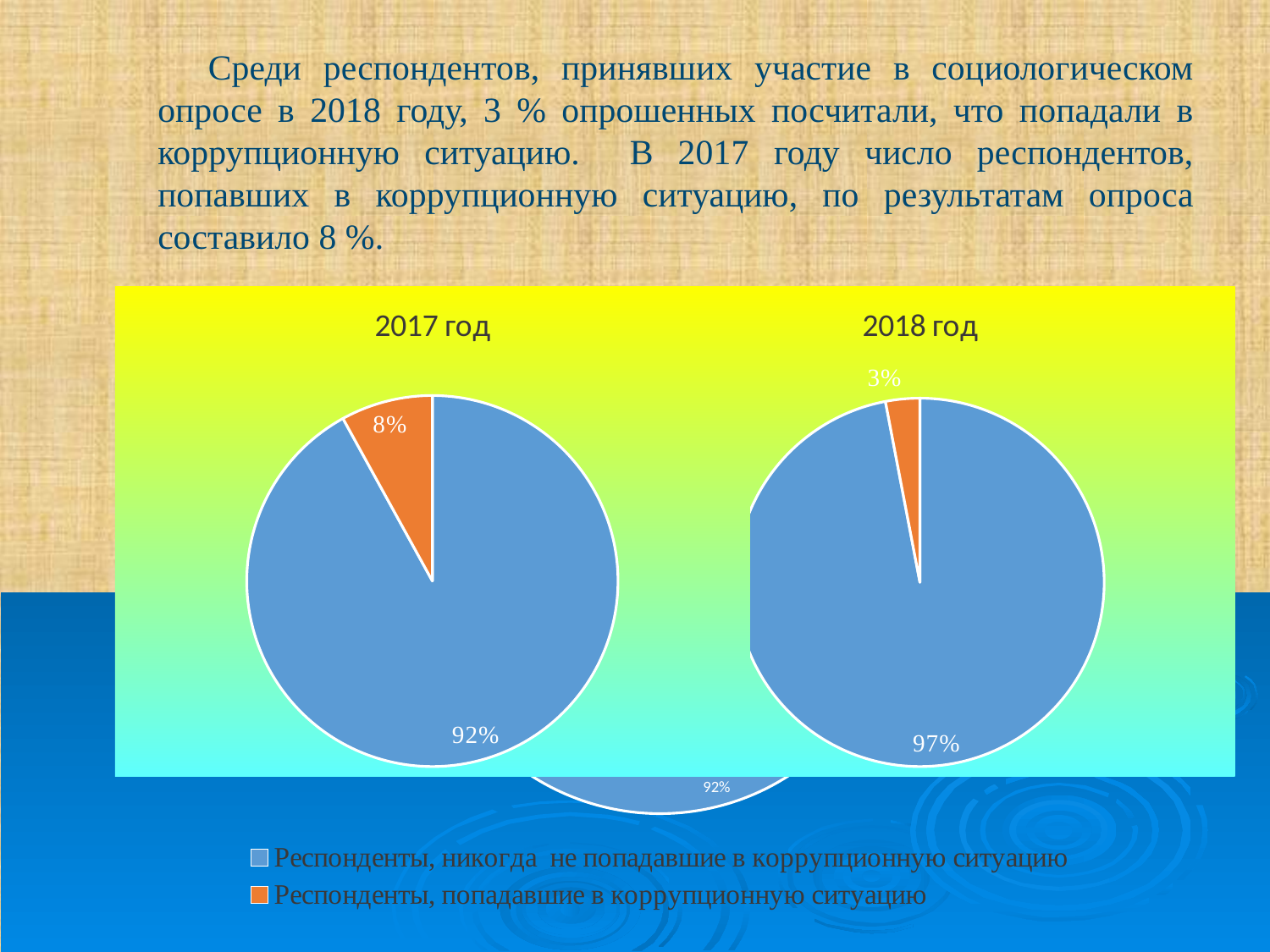
In the "2018 год" chart, what share of respondents fell into a corruption situation (Респонденты, попадавшие в коррупционную ситуацию)? 3% By how many percentage points did the share of respondents who fell into a corruption situation change from the "2017 год" chart to the "2018 год" chart? 5 percentage points In the "2017 год" chart, which slice is the largest? Респонденты, никогда не попадавшие в коррупционную ситуацию In the "2017 год" chart, what share of respondents never fell into a corruption situation? 92% How many slices does the "2018 год" pie chart have? 2 What type of chart is used for "2017 год" and "2018 год"? Pie chart How many entries does the legend list? 2 What colour represents respondents who fell into a corruption situation in the pie charts? Orange Which chart shows a larger share of respondents who fell into a corruption situation, "2017 год" or "2018 год"? 2017 год In the "2018 год" chart, which slice is the smallest? Респонденты, попадавшие в коррупционную ситуацию In the "2018 год" chart, what share of respondents never fell into a corruption situation? 97% In the "2017 год" chart, what share of respondents fell into a corruption situation (Респонденты, попадавшие в коррупционную ситуацию)? 8%